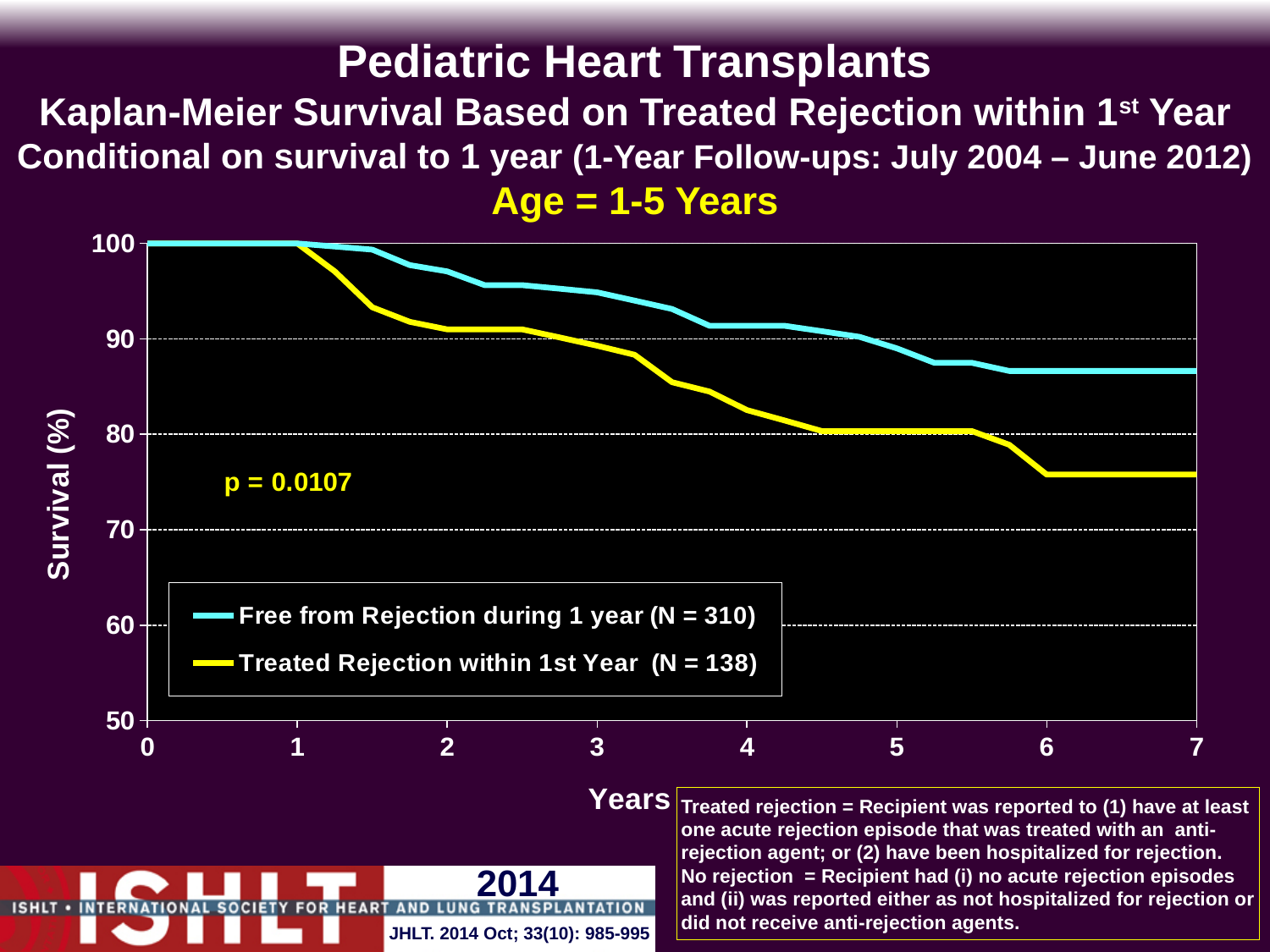
Is the survival for the Free from Rejection during 1 year group at 3 years greater or less than 90? greater Is the survival for the Free from Rejection during 1 year group at 7 years greater or less than 80? greater Do the survival curves rise or fall as years since transplant increase? Fall What p-value is printed on the chart? p = 0.0107 Is the survival for the Free from Rejection during 1 year group at 7 years greater or less than 90? less At 5 years, which group has higher survival: Free from Rejection during 1 year or Treated Rejection within 1st Year? Free from Rejection during 1 year What is the N for the Free from Rejection during 1 year group shown in the legend? 310 How many tick marks are labeled on the Years axis? 8 How many series does the legend list? 2 What kind of chart is shown on the slide? Line chart